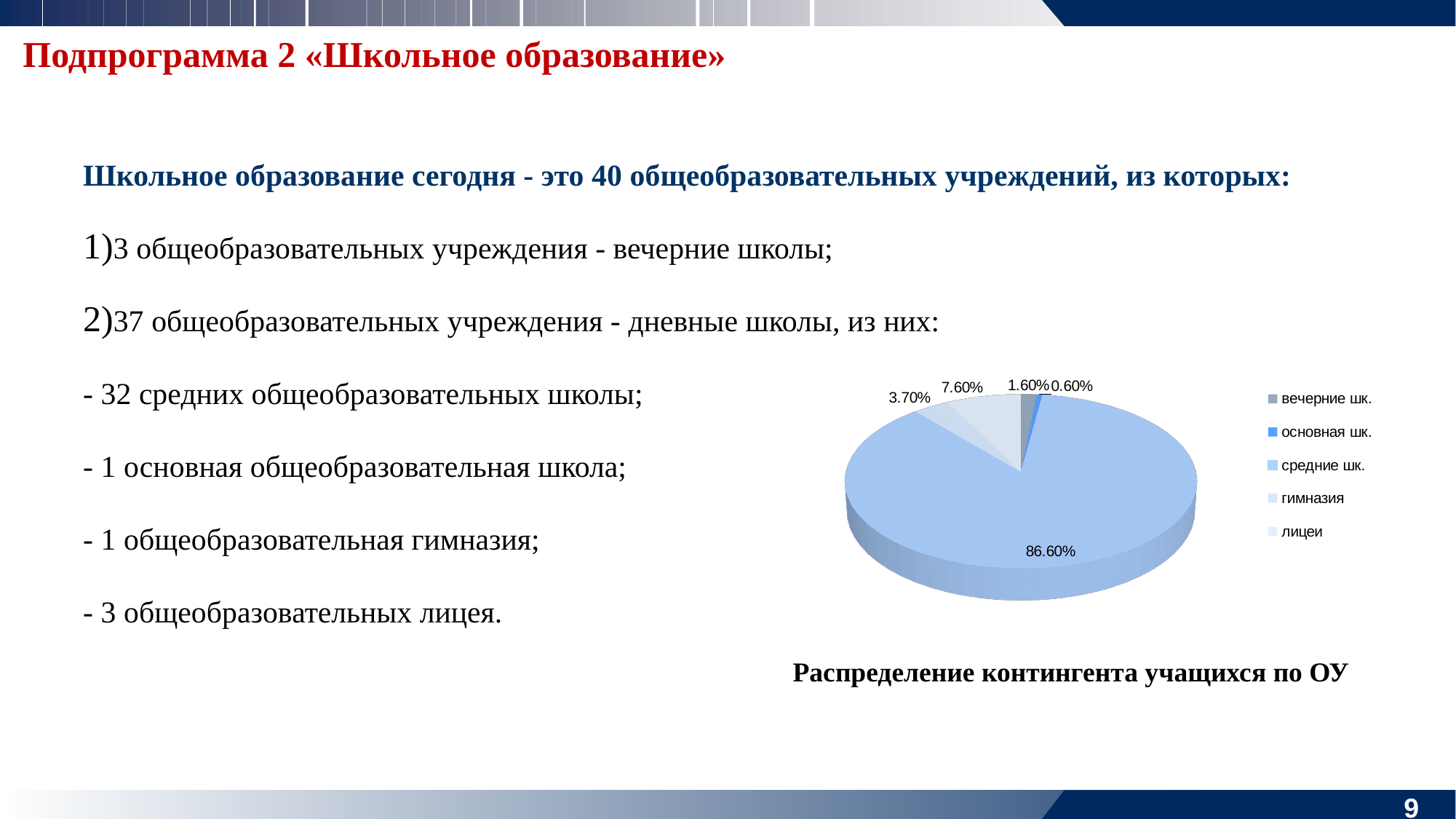
What kind of chart is shown on the slide? pie chart How many slices does the pie chart have? 5 What is the title of the chart on the slide? Распределение контингента учащихся по ОУ What share of the pie is labelled for основная шк.? 0.60% What share of the pie is labelled for лицеи? 7.60% What is the difference between the share for средние шк. and the share for лицеи? 79.00% Which has a larger share of the pie, вечерние шк. or основная шк.? вечерние шк. Which category has the largest share of the pie? средние шк. What share of the pie is labelled for вечерние шк.? 1.60% How many entries does the chart legend list? 5 Which category has the smallest share of the pie? основная шк.